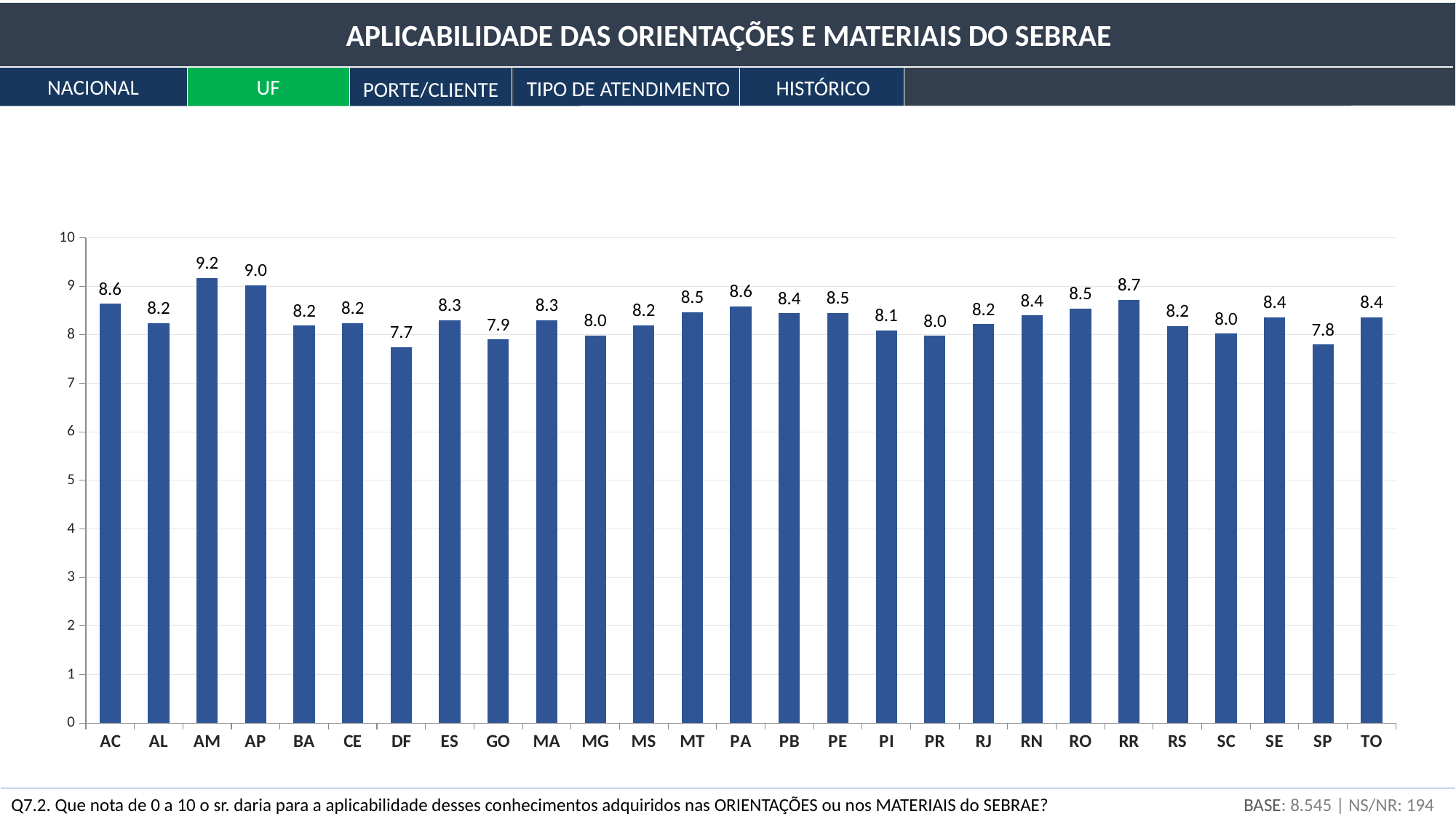
What is the value for AM? 9.2 What is the difference between the values for AP and GO? 1.1 Which state has the highest value? AM What is the value for RR? 8.7 What is the title of the slide? APLICABILIDADE DAS ORIENTAÇÕES E MATERIAIS DO SEBRAE Which is larger, the value for AC or the value for AL? AC What kind of chart is shown on the slide? Bar chart What is the value for SP? 7.8 Which state has the lowest value? DF What is the difference between the values for AM and DF? 1.5 What is the value for DF? 7.7 How many states are shown on the x axis? 27